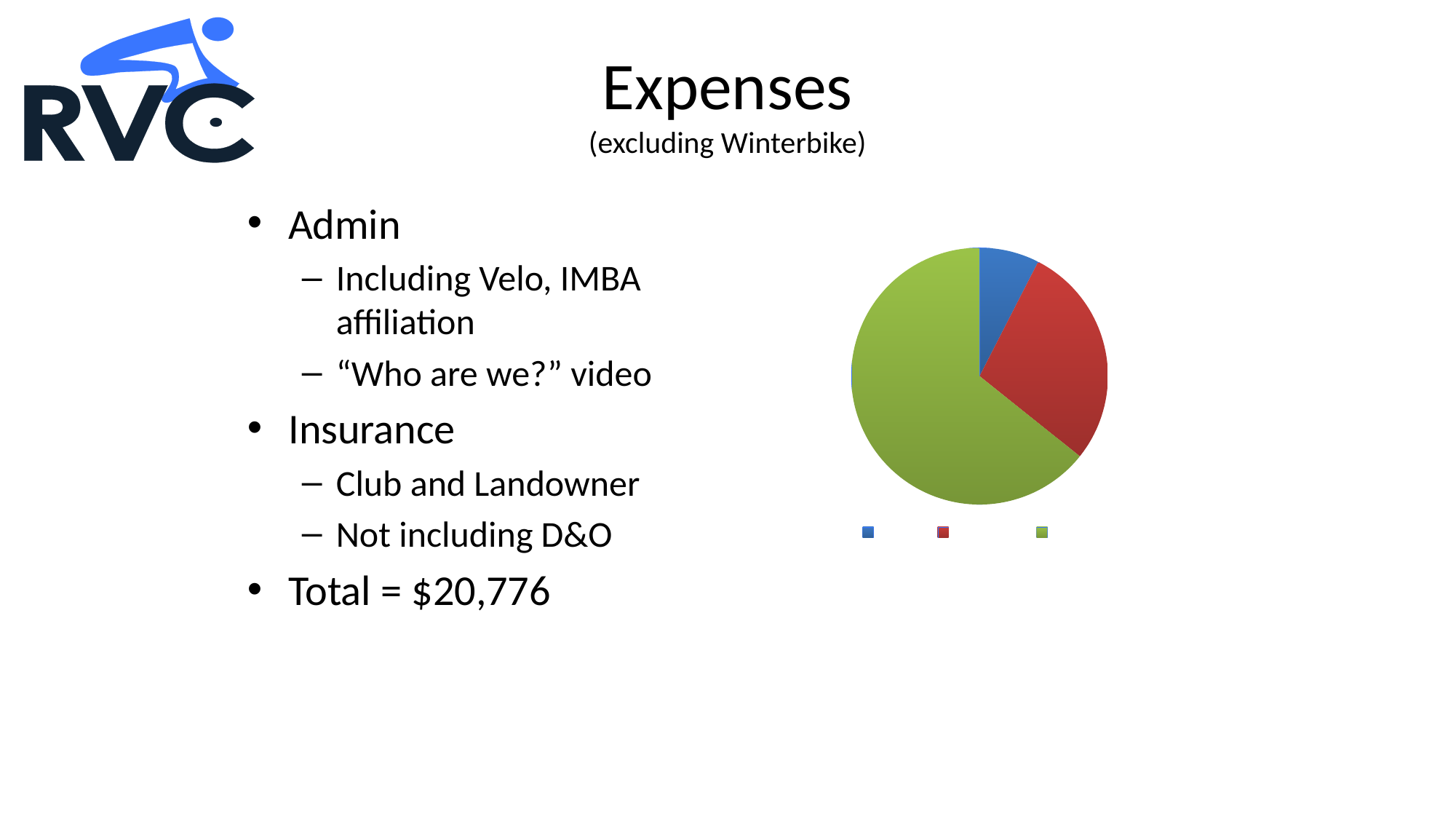
In the pie chart, which is larger, the red slice or the blue slice? red What colours are used for the slices of the pie chart? blue, red and green How many slices does the pie chart have? 3 Where is the legend positioned relative to the pie chart? below it Which colour slice is the largest in the pie chart? green What kind of chart is shown on the slide? pie chart Does the green slice take up more or less than half of the pie chart? more Which colour slice is the smallest in the pie chart? blue In the pie chart, which is larger, the green slice or the red slice? green How many entries does the legend below the pie chart list? 3